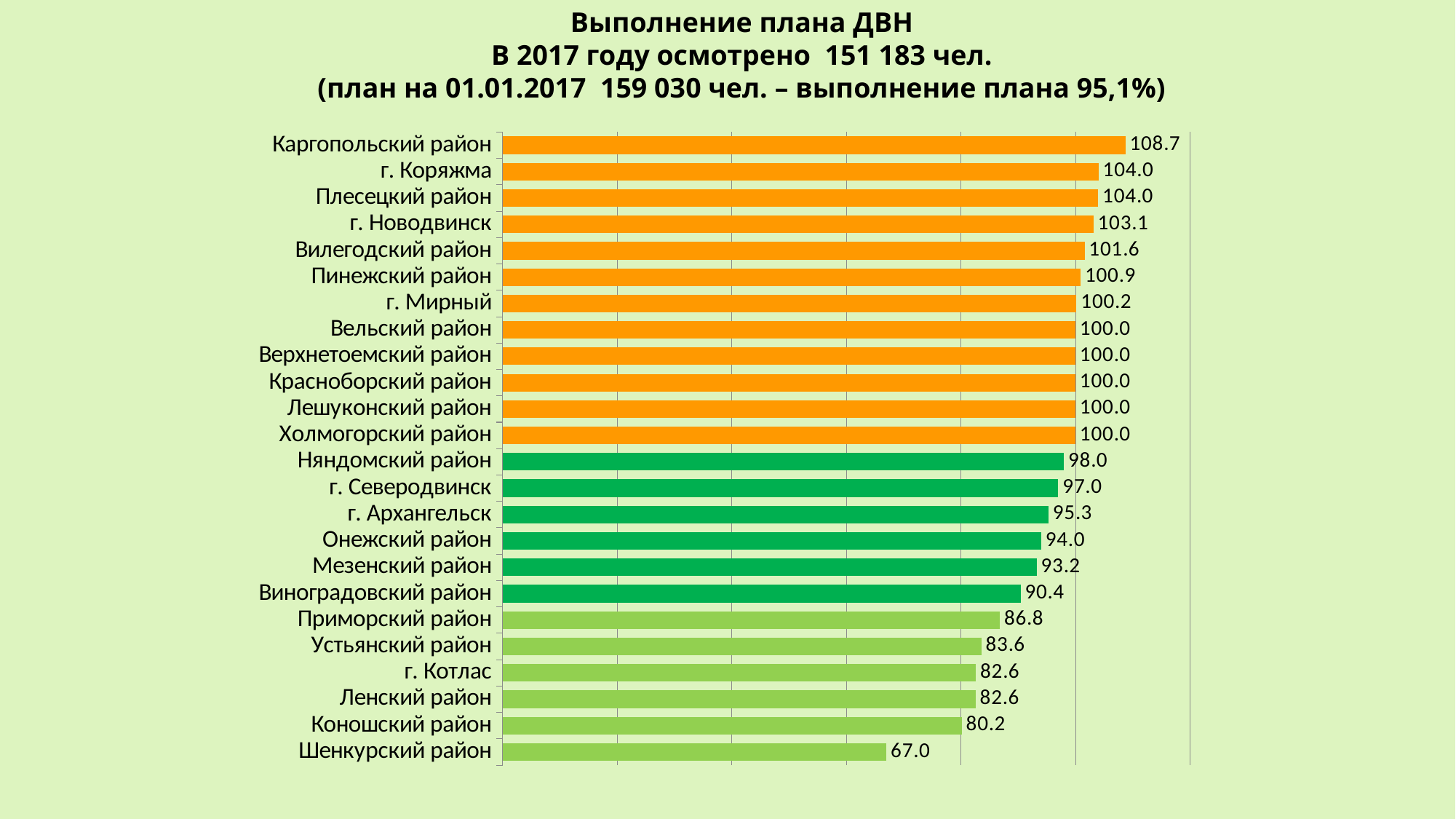
What kind of chart is shown on the slide? Bar chart How many categories are shown in the chart? 24 What is the value for Каргопольский район? 108.7 What is the difference between the values for Каргопольский район and Шенкурский район? 41.7 What colour are the bars for categories with values of 100.0 or more? Orange Which is larger, the value for Онежский район or the value for Устьянский район? Онежский район What is the value for Шенкурский район? 67.0 Which category has the lowest value? Шенкурский район What is the difference between the values for г. Северодвинск and г. Котлас? 14.4 What is the value for Приморский район? 86.8 What is the value for г. Архангельск? 95.3 Which category has the highest value? Каргопольский район